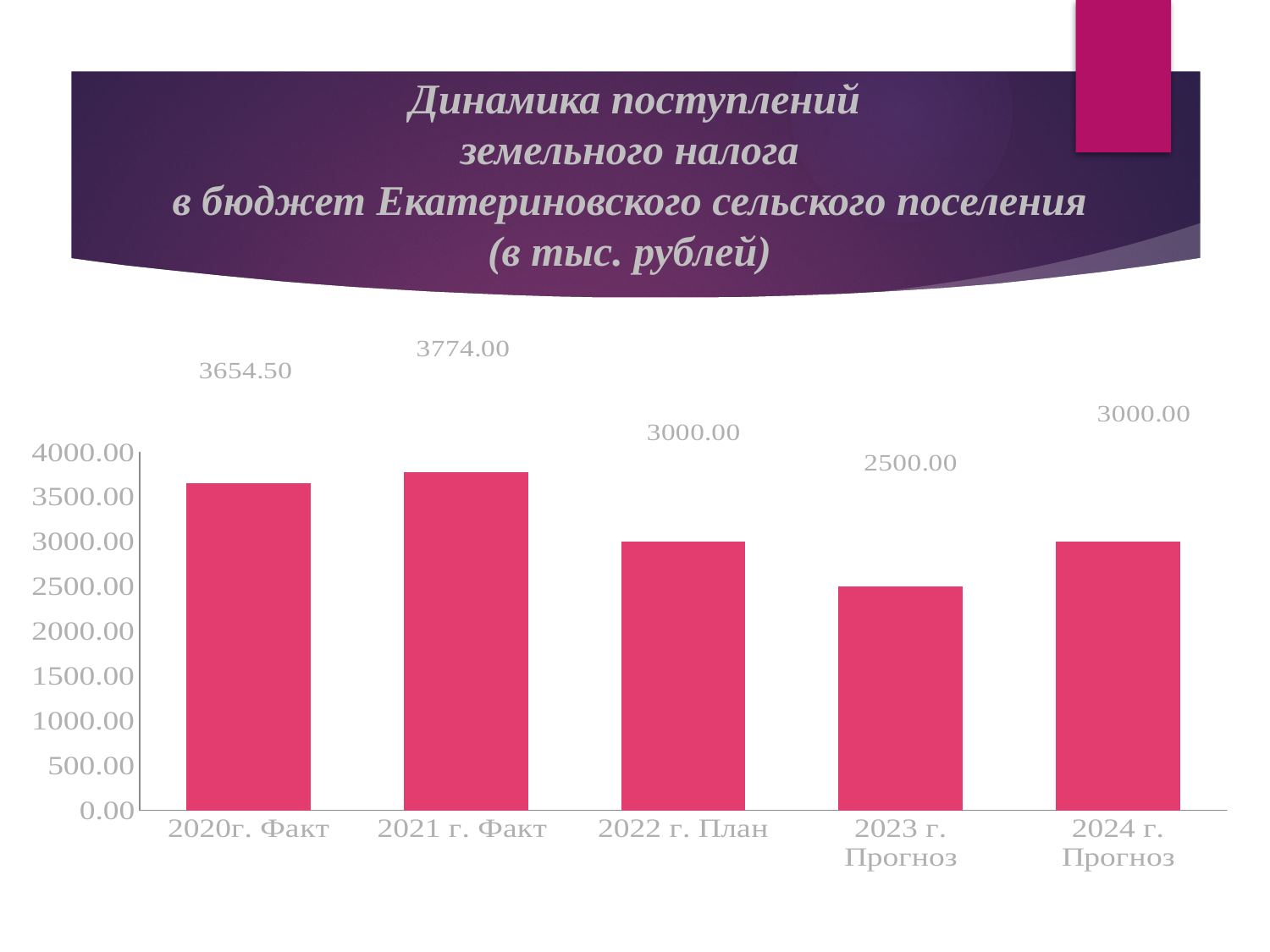
Which is larger, the value for 2020г. Факт or the value for 2024 г. Прогноз? 2020г. Факт What kind of chart is shown on the slide? bar chart What is the difference between the values for 2022 г. План and 2023 г. Прогноз? 500.00 Is the value for 2023 г. Прогноз greater or less than 3000.00? less What is the value for 2021 г. Факт? 3774.00 What is the difference between the values for 2021 г. Факт and 2020г. Факт? 119.50 How many categories are shown on the x axis? 5 In what units are the values on the chart given, according to the title? тыс. рублей What is the value for 2023 г. Прогноз? 2500.00 Which category has the highest value? 2021 г. Факт What is the value for 2020г. Факт? 3654.50 Which category has the lowest value? 2023 г. Прогноз